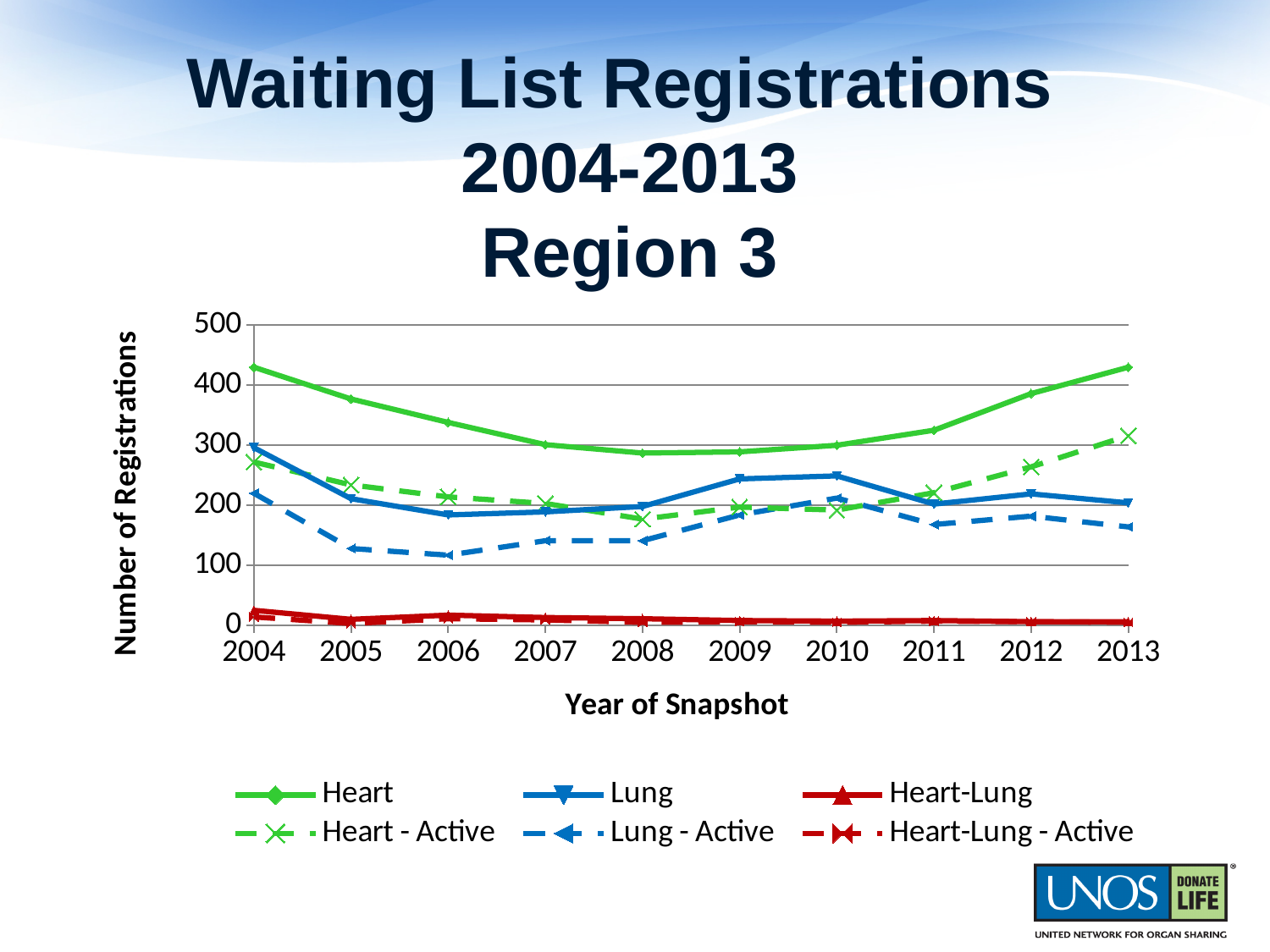
How many series does the legend list? 6 Is the value for Heart-Lung in 2013 greater or less than 100? less How many years are plotted along the x axis? 10 What is the label of the y axis? Number of Registrations What kind of chart is shown on the slide? Line chart Is the value for Lung in 2006 greater or less than 200? less In which year is the Heart - Active series at its highest? 2013 Does the Heart series rise or fall from 2004 to 2008? fall Is the value for Heart in 2004 greater or less than 400? greater In which year is the Lung series at its highest? 2004 Which is larger in 2010, Lung or Heart - Active? Lung